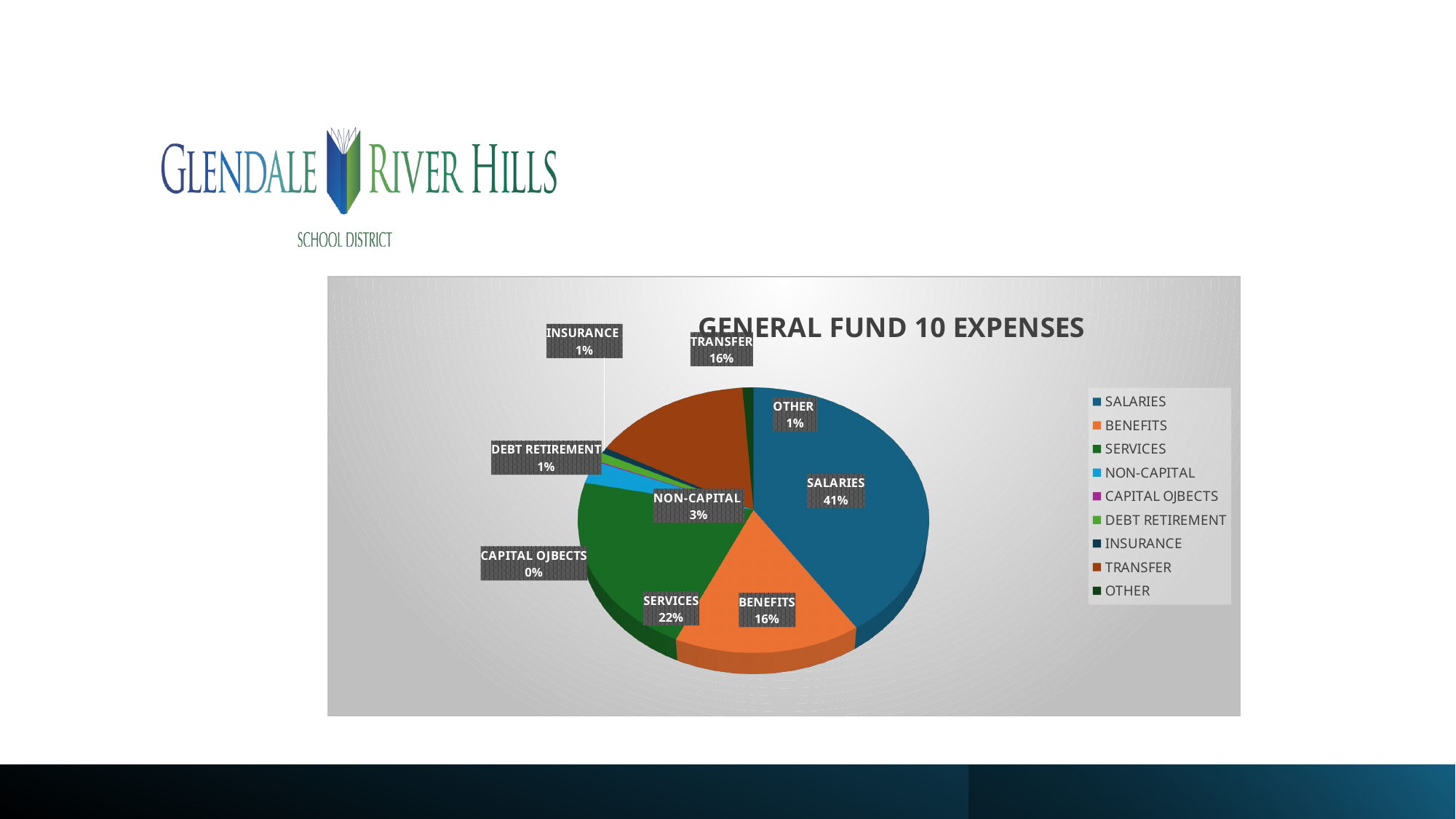
What is the title of the chart? GENERAL FUND 10 EXPENSES Which category has the smallest share of expenses? CAPITAL OJBECTS How many categories does the legend list? 9 What percentage of expenses is Debt Retirement? 1% Which category has the largest share of expenses? SALARIES What percentage of expenses is Services? 22% What share of General Fund 10 expenses is Salaries? 41% What type of chart is shown on the slide? Pie chart What is the difference in percentage points between Salaries and Services? 19 percentage points What colour represents Transfer in the pie chart? Brown Which is larger, the share for Services or the share for Transfer? Services What percentage of expenses is Non-Capital? 3%